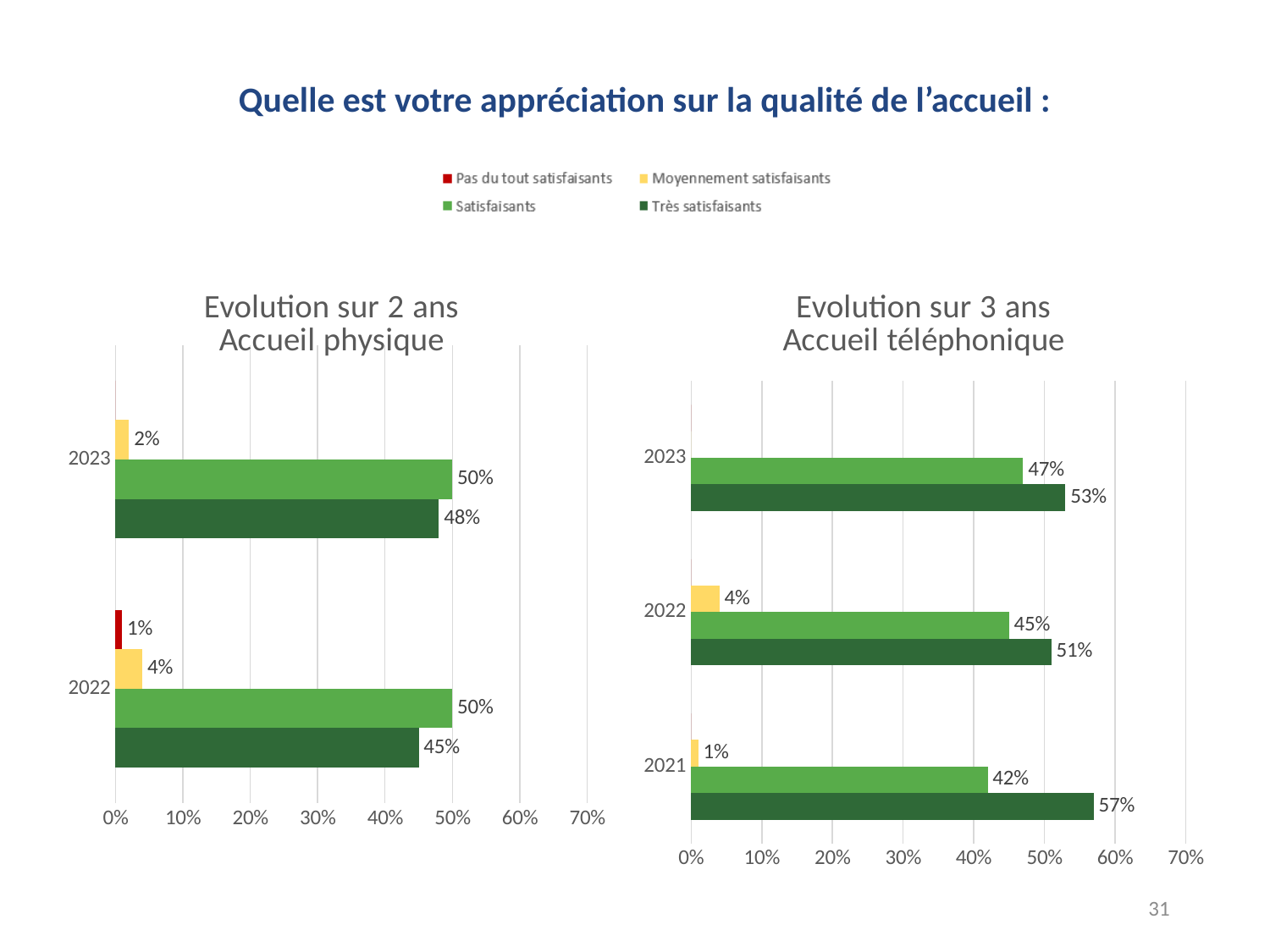
How many years are shown in the 'Evolution sur 3 ans Accueil téléphonique' chart? 3 In the 'Evolution sur 3 ans Accueil téléphonique' chart, what is the difference between 'Très satisfaisants' and 'Satisfaisants' in 2023? 6% In the 'Evolution sur 2 ans Accueil physique' chart, what is the value for 'Moyennement satisfaisants' in 2022? 4% In the 'Evolution sur 3 ans Accueil téléphonique' chart, what is the value for 'Satisfaisants' in 2022? 45% What kind of chart is the 'Evolution sur 2 ans Accueil physique' chart? Bar chart How many series does the legend list? 4 In the 'Evolution sur 3 ans Accueil téléphonique' chart, is the value for 'Très satisfaisants' in 2022 greater or less than 40%? greater In the 'Evolution sur 3 ans Accueil téléphonique' chart, what is the value for 'Très satisfaisants' in 2021? 57% In the 'Evolution sur 2 ans Accueil physique' chart, what is the value for 'Très satisfaisants' in 2023? 48% In the 'Evolution sur 3 ans Accueil téléphonique' chart, which year has the highest value for 'Très satisfaisants'? 2021 In the 'Evolution sur 2 ans Accueil physique' chart, what is the value for 'Pas du tout satisfaisants' in 2022? 1% In the 'Evolution sur 2 ans Accueil physique' chart, which is larger in 2023: 'Satisfaisants' or 'Très satisfaisants'? Satisfaisants